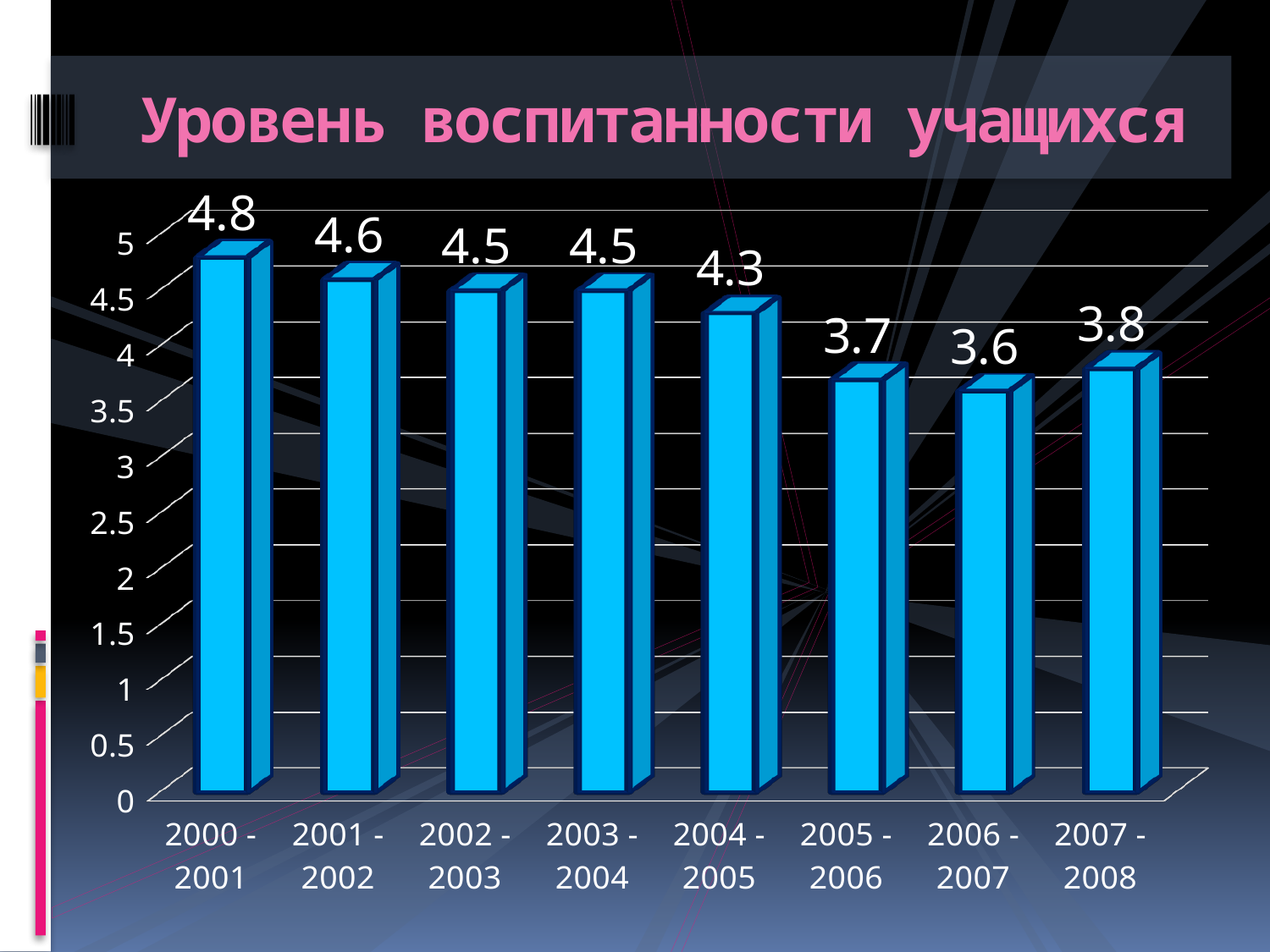
Which category has the highest value? 2000 - 2001 What is the value for 2006 - 2007? 3.6 What is the value for 2000 - 2001? 4.8 Which is larger, the value for 2001 - 2002 or the value for 2007 - 2008? 2001 - 2002 Is the value for 2005 - 2006 greater or less than 4? less What kind of chart is shown on the slide? bar chart What is the difference between the values for 2000 - 2001 and 2007 - 2008? 1 What is the value for 2004 - 2005? 4.3 Which category has the lowest value? 2006 - 2007 How many categories are shown on the x axis? 8 What is the difference between the values for 2004 - 2005 and 2005 - 2006? 0.6 What is the title of the chart? Уровень воспитанности учащихся